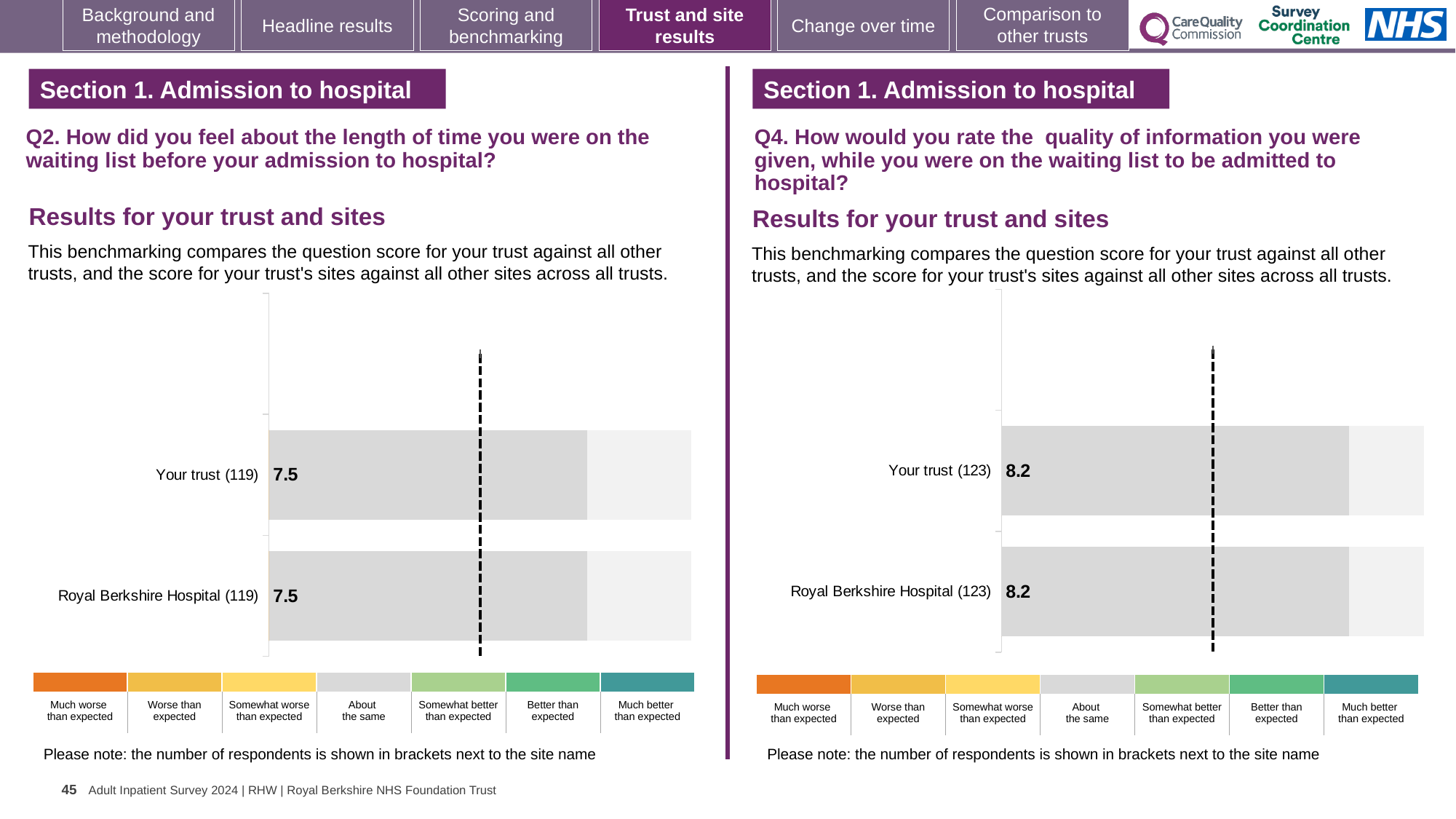
In the Q2 chart on the left, what is the difference between the score for Your trust and the score for Royal Berkshire Hospital? 0 In the Q2 chart on the left, what is the score for Your trust? 7.5 In the Q2 chart on the left, how many respondents are shown in brackets for Your trust? 119 What kind of chart is used in the Q2 chart on the left? Bar chart In the Q2 chart on the left, what is the score for Royal Berkshire Hospital? 7.5 In the Q4 chart on the right, what is the score for Your trust? 8.2 In the Q4 chart on the right, how many respondents are shown in brackets for Royal Berkshire Hospital? 123 In the Q4 chart on the right, what is the difference between the score for Your trust and the score for Royal Berkshire Hospital? 0 Is the score for Your trust in the Q4 chart on the right larger or smaller than the score for Your trust in the Q2 chart on the left? Larger How many bars are plotted in the Q4 chart on the right? 2 How many bars are plotted in the Q2 chart on the left? 2 In the Q4 chart on the right, what is the score for Royal Berkshire Hospital? 8.2